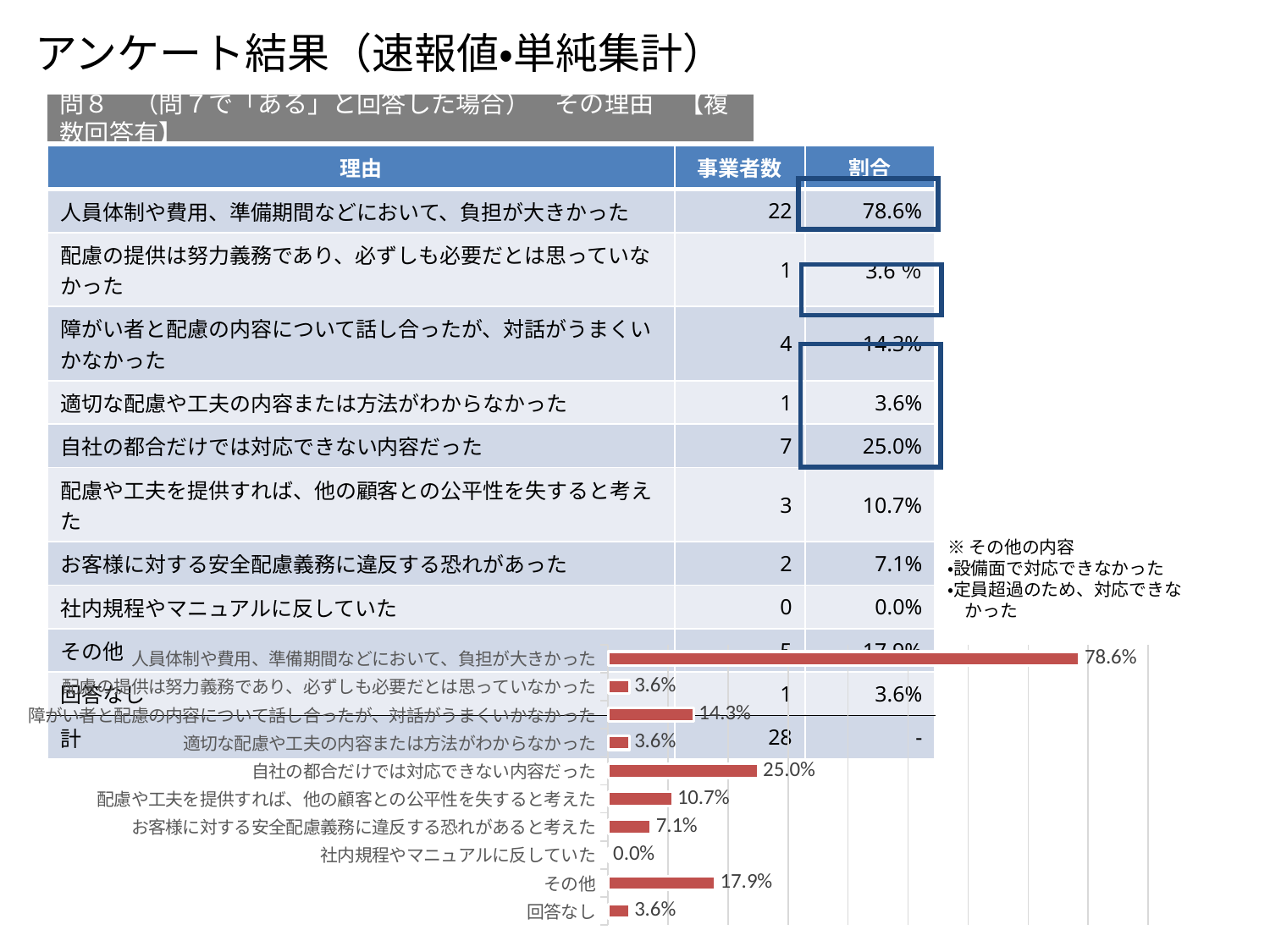
In the bar chart, what is the value for その他? 17.9% How many categories are plotted in the bar chart? 10 In the bar chart, what is the value for 自社の都合だけでは対応できない内容だった? 25.0% In the bar chart, what is the value for お客様に対する安全配慮義務に違反する恐れがあると考えた? 7.1% In the bar chart, what is the value for 人員体制や費用、準備期間などにおいて、負担が大きかった? 78.6% In the bar chart, which is larger: the value for 自社の都合だけでは対応できない内容だった or the value for その他? 自社の都合だけでは対応できない内容だった In the bar chart, what is the value for 社内規程やマニュアルに反していた? 0.0% What kind of chart is shown at the bottom of the slide? bar chart Which category has the lowest value in the bar chart? 社内規程やマニュアルに反していた In the bar chart, what is the value for 障がい者と配慮の内容について話し合ったが、対話がうまくいかなかった? 14.3% Which category has the highest value in the bar chart? 人員体制や費用、準備期間などにおいて、負担が大きかった In the bar chart, what is the difference between the value for 人員体制や費用、準備期間などにおいて、負担が大きかった and the value for 自社の都合だけでは対応できない内容だった? 53.6%